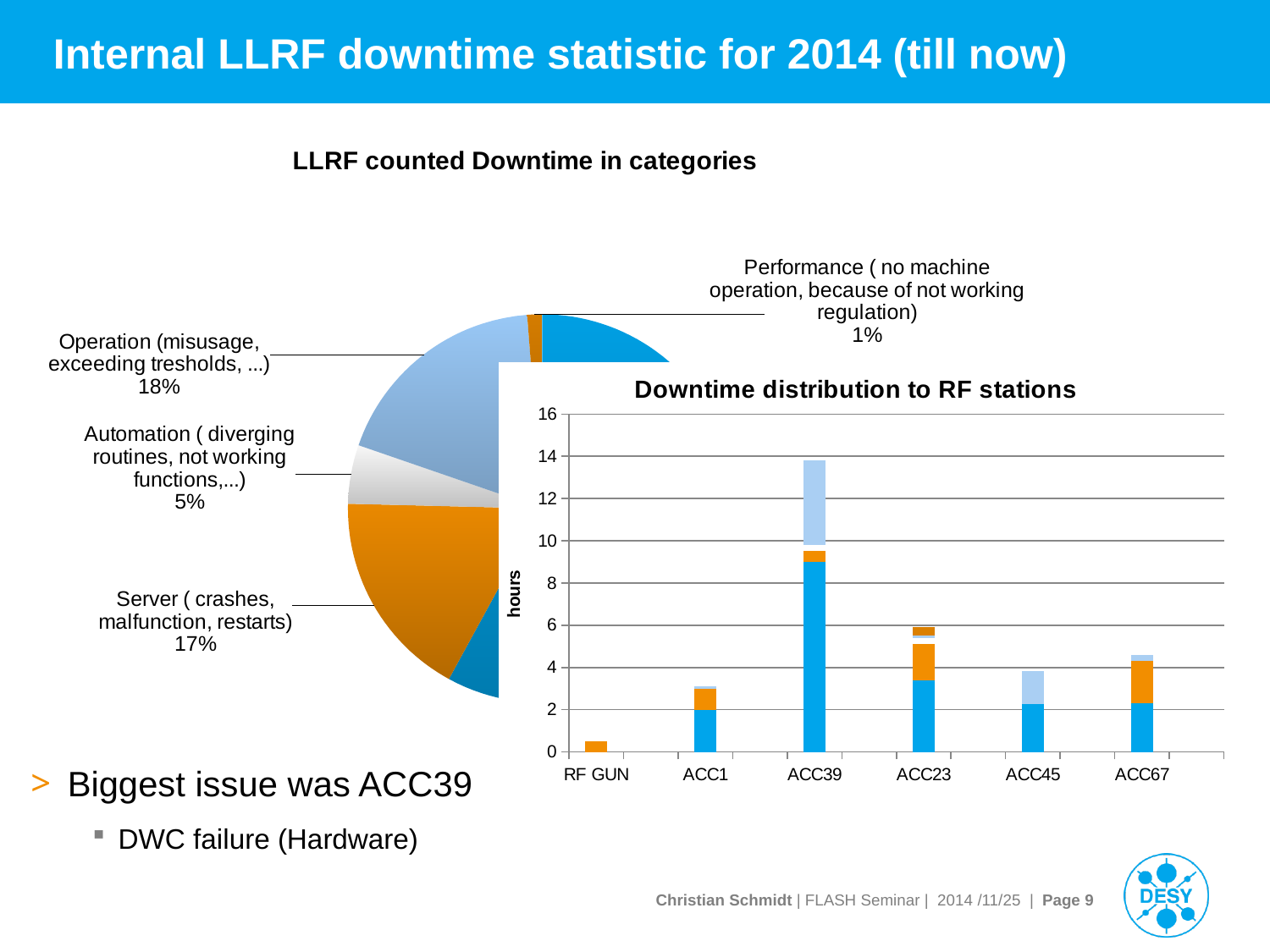
How many RF stations are shown on the x axis of the 'Downtime distribution to RF stations' chart? 6 What is the title of the bar chart on the right side of the slide? Downtime distribution to RF stations What kind of chart is 'Downtime distribution to RF stations'? bar chart In the 'Downtime distribution to RF stations' chart, which RF station has the highest downtime? ACC39 In the 'LLRF counted Downtime in categories' pie chart, what share is attributed to Server (crashes, malfunction, restarts)? 17% What is the label on the vertical axis of the 'Downtime distribution to RF stations' chart? hours In the 'Downtime distribution to RF stations' chart, is the downtime for RF GUN greater or less than 2 hours? less In the 'Downtime distribution to RF stations' chart, which RF station has the lowest downtime? RF GUN In the 'Downtime distribution to RF stations' chart, which has more downtime, ACC23 or ACC67? ACC23 In the 'LLRF counted Downtime in categories' pie chart, what share is attributed to Operation (misusage, exceeding tresholds, ...)? 18% In the 'Downtime distribution to RF stations' chart, is the total downtime for ACC67 greater or less than 6 hours? less In the 'Downtime distribution to RF stations' chart, is the total downtime for ACC39 greater or less than 12 hours? greater